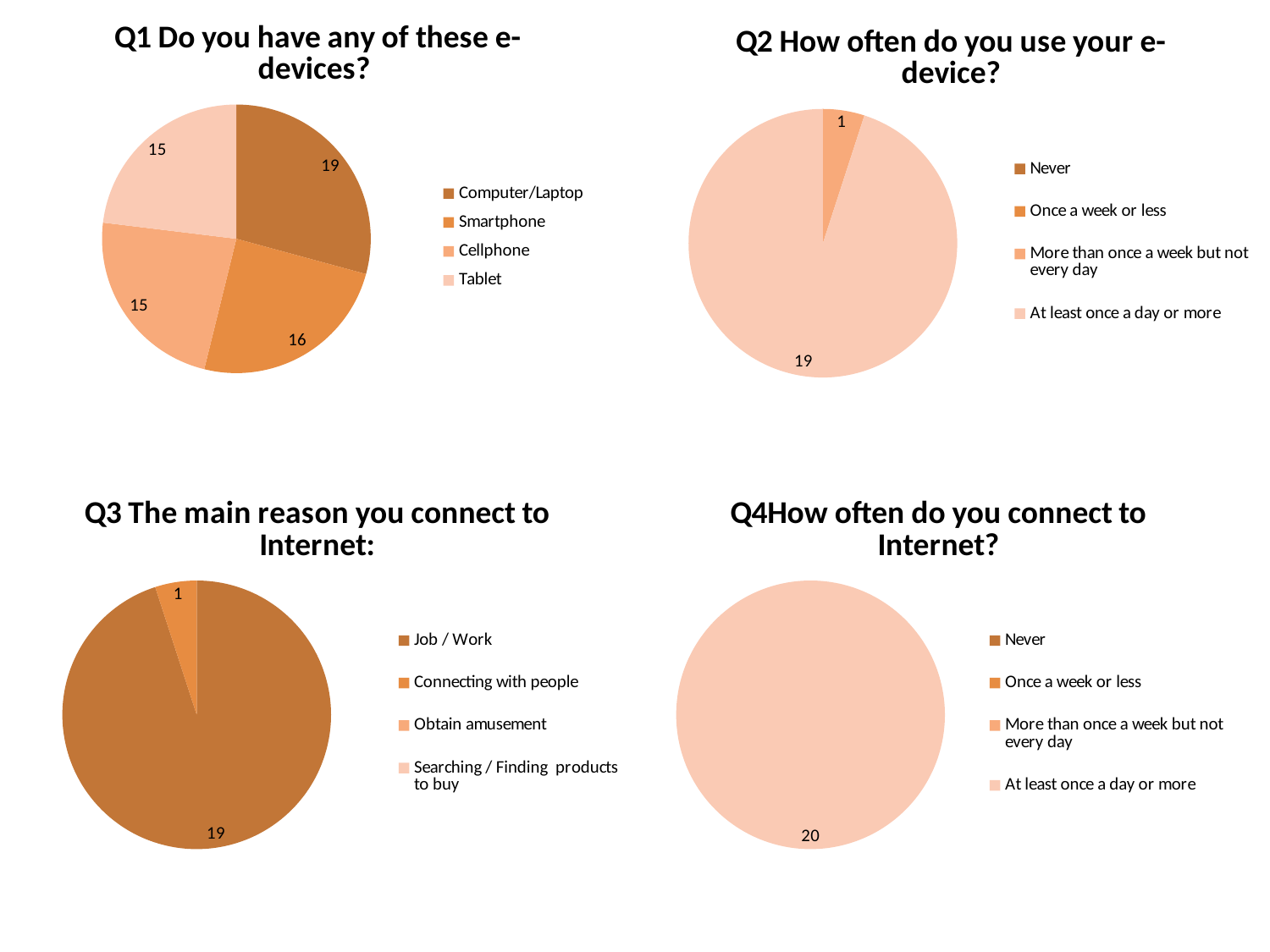
In the Q2 chart, which is larger: 'Once a week or less' or 'At least once a day or more'? At least once a day or more In the Q1 chart, how many respondents have a Computer/Laptop? 19 In the Q1 chart, what is the difference between the Computer/Laptop value and the Smartphone value? 3 In the Q3 chart, what is the value for Job / Work? 19 In the Q3 chart, what share of the pie does Job / Work represent? 95% In the Q4 chart, what is the value for 'At least once a day or more'? 20 In the Q1 chart, what is the value for Smartphone? 16 In the Q2 chart, what is the value for 'At least once a day or more'? 19 In the Q1 chart, which device has the largest slice? Computer/Laptop In the Q1 chart, how many categories does the legend list? 4 What type of chart is used for Q4? Pie chart